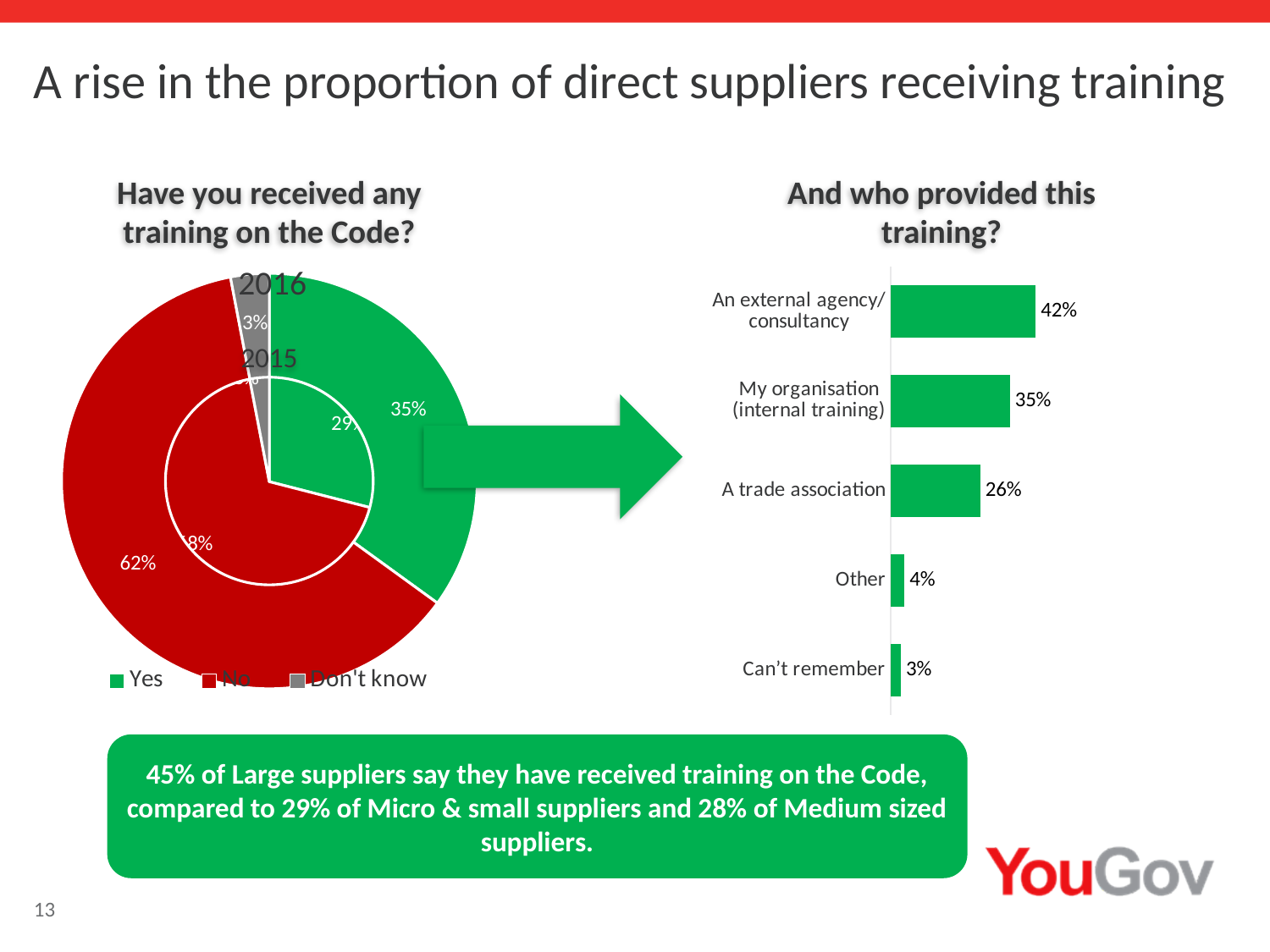
In the bar chart 'And who provided this training?', how many categories are shown? 5 In the bar chart 'And who provided this training?', what percentage said a trade association provided the training? 26% In the bar chart 'And who provided this training?', what percentage said an external agency/consultancy provided the training? 42% In the bar chart 'And who provided this training?', what is the difference between 'An external agency/consultancy' and 'My organisation (internal training)'? 7% In the pie chart 'Have you received any training on the Code?', what is the difference between the 'No' and 'Yes' shares in 2016? 27% In the pie chart 'Have you received any training on the Code?', which response had the largest share in 2016? No What type of chart is 'And who provided this training?' Bar chart In the bar chart 'And who provided this training?', which provider has the lowest percentage? Can't remember In the pie chart 'Have you received any training on the Code?', what percentage of direct suppliers answered 'Yes' in 2016? 35% In the pie chart 'Have you received any training on the Code?', what percentage answered 'No' in 2016? 62% In the pie chart 'Have you received any training on the Code?', what percentage answered 'Don't know' in 2016? 3% In the pie chart 'Have you received any training on the Code?', how many entries does the legend list? 3